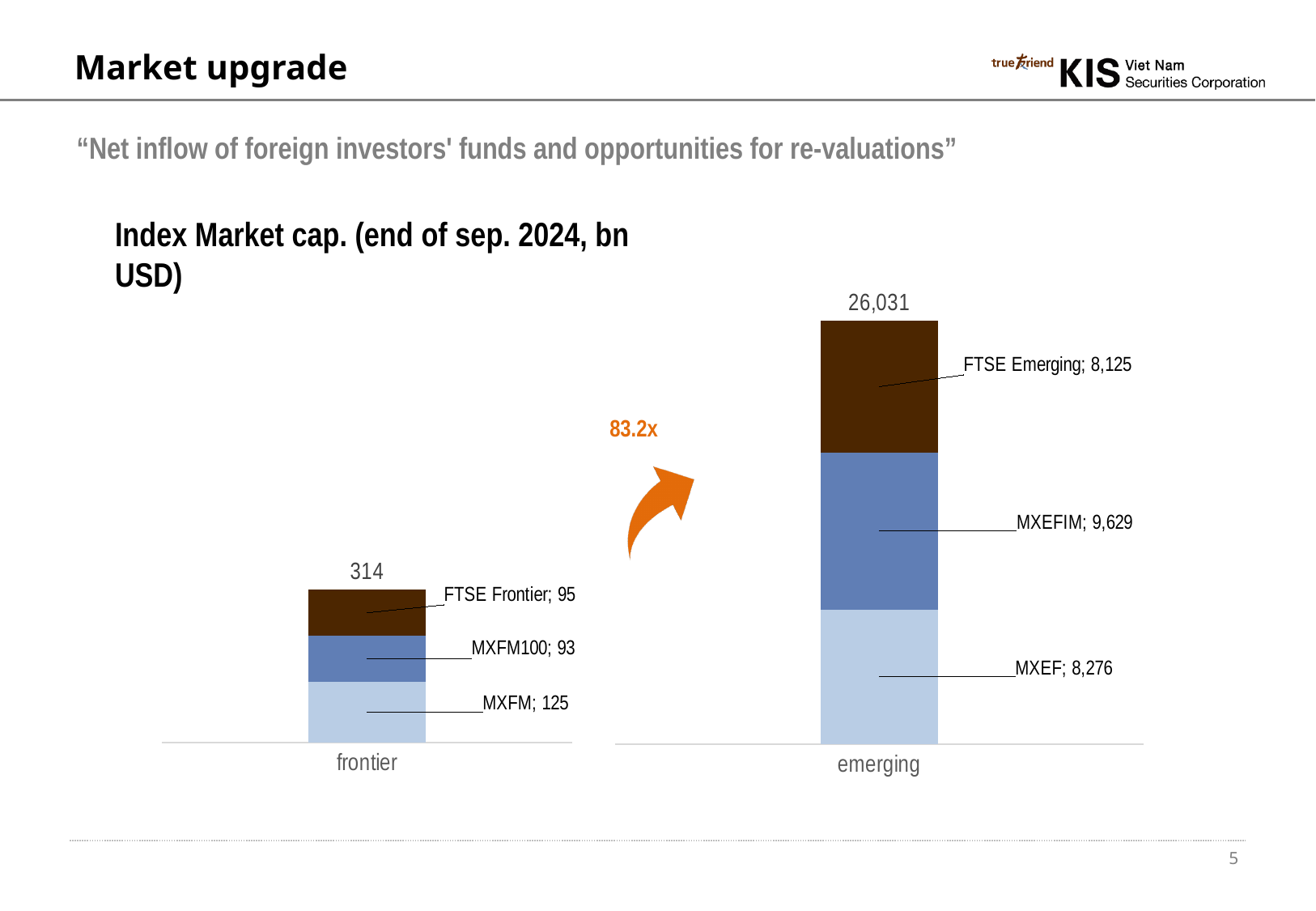
What is the difference between the MXEFIM and MXEF segments in the emerging bar? 1,353 What is the value of the FTSE Frontier segment in the frontier bar? 95 What total is printed above the emerging bar? 26,031 What kind of chart is shown on the slide? Stacked bar chart Which segment of the frontier bar is the smallest? MXFM100 What is the value of the MXFM segment in the frontier bar? 125 What is the value of the MXEFIM segment in the emerging bar? 9,629 Which is larger, the MXFM segment in the frontier bar or the FTSE Frontier segment? MXFM What is the value of the FTSE Emerging segment in the emerging bar? 8,125 Which segment of the emerging bar is the largest? MXEFIM What is the value of the MXEF segment in the emerging bar? 8,276 What total is printed above the frontier bar? 314